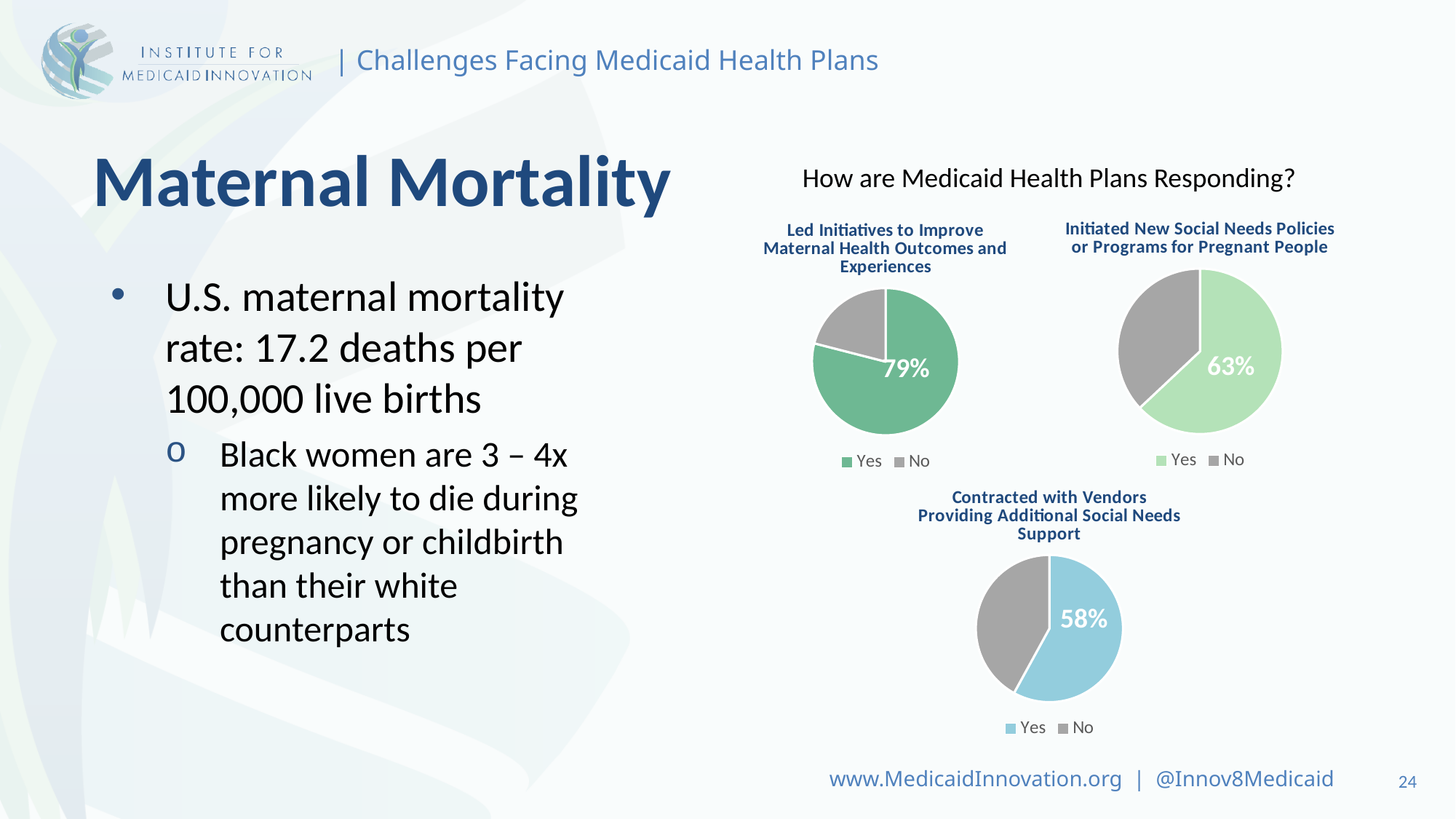
What is the difference in Yes percentage between the "Led Initiatives to Improve Maternal Health Outcomes and Experiences" chart and the "Contracted with Vendors Providing Additional Social Needs Support" chart? 21% How many pie charts are shown on the slide? 3 Which of the three pie charts has the largest Yes share? Led Initiatives to Improve Maternal Health Outcomes and Experiences Is the Yes share larger in the "Initiated New Social Needs Policies or Programs for Pregnant People" chart or in the "Contracted with Vendors Providing Additional Social Needs Support" chart? Initiated New Social Needs Policies or Programs for Pregnant People What colour represents the No slice in the "Contracted with Vendors Providing Additional Social Needs Support" pie chart? Gray Which of the three pie charts has the smallest Yes share? Contracted with Vendors Providing Additional Social Needs Support In the pie chart titled "Contracted with Vendors Providing Additional Social Needs Support", what percentage answered Yes? 58% In the pie chart titled "Initiated New Social Needs Policies or Programs for Pregnant People", what percentage answered Yes? 63% In the pie chart titled "Led Initiatives to Improve Maternal Health Outcomes and Experiences", what percentage answered Yes? 79% What is the heading above the three pie charts? How are Medicaid Health Plans Responding? How many entries does the legend of the "Contracted with Vendors Providing Additional Social Needs Support" pie chart list? 2 What kind of chart is used for "Led Initiatives to Improve Maternal Health Outcomes and Experiences"? Pie chart